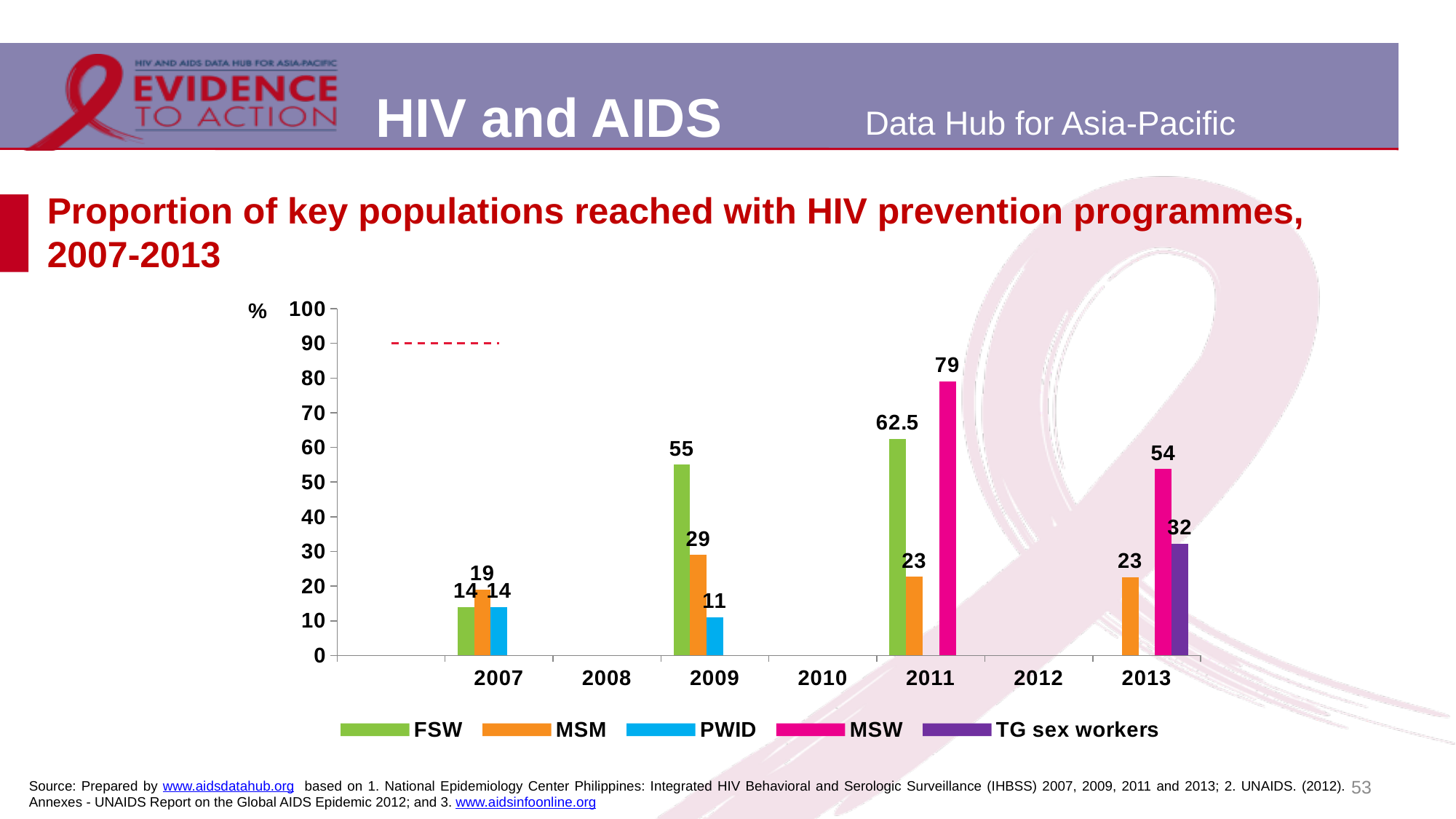
Which years on the x axis have no bars plotted? 2008, 2010 and 2012 Which is larger, the FSW value in 2009 or the MSM value in 2009? FSW How does the FSW value change from 2007 to 2011? It rises Which series has the lowest value in 2009? PWID What is the value for TG sex workers in 2013? 32 What kind of chart is shown on the slide? bar chart How many series does the legend list? 5 What is the value for MSW in 2013? 54 What is the difference between the MSW value and the FSW value in 2011? 16.5 What is the value for FSW in 2011? 62.5 Which series has the highest value in 2011? MSW What is the value for PWID in 2009? 11